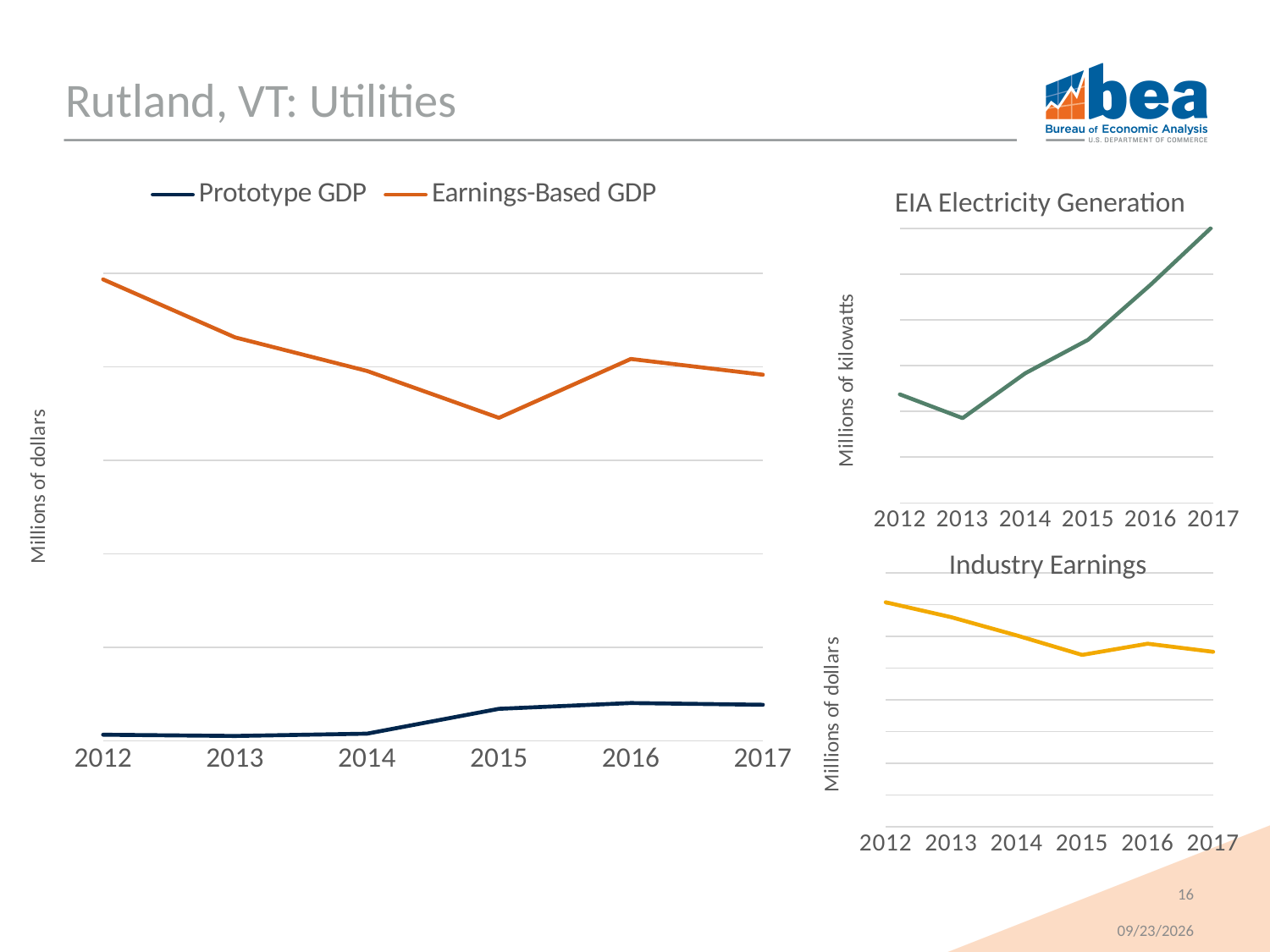
On the large left chart, in which year is Earnings-Based GDP highest? 2012 What is the y-axis label of the EIA Electricity Generation chart? Millions of kilowatts What kind of chart is the large left chart? Line chart On the EIA Electricity Generation chart, in which year is the value highest? 2017 On the large left chart, what are the two series named in the legend? Prototype GDP and Earnings-Based GDP On the large left chart, how many series does the legend list? 2 On the large left chart, in which year is Earnings-Based GDP lowest? 2015 On the large left chart, which series has the higher value in 2012, Prototype GDP or Earnings-Based GDP? Earnings-Based GDP On the large left chart, how many years are shown on the x axis? 6 On the EIA Electricity Generation chart, in which year is the value lowest? 2013 On the large left chart, does Prototype GDP rise or fall from 2014 to 2015? Rise On the Industry Earnings chart, does the value rise or fall from 2012 to 2015? Fall